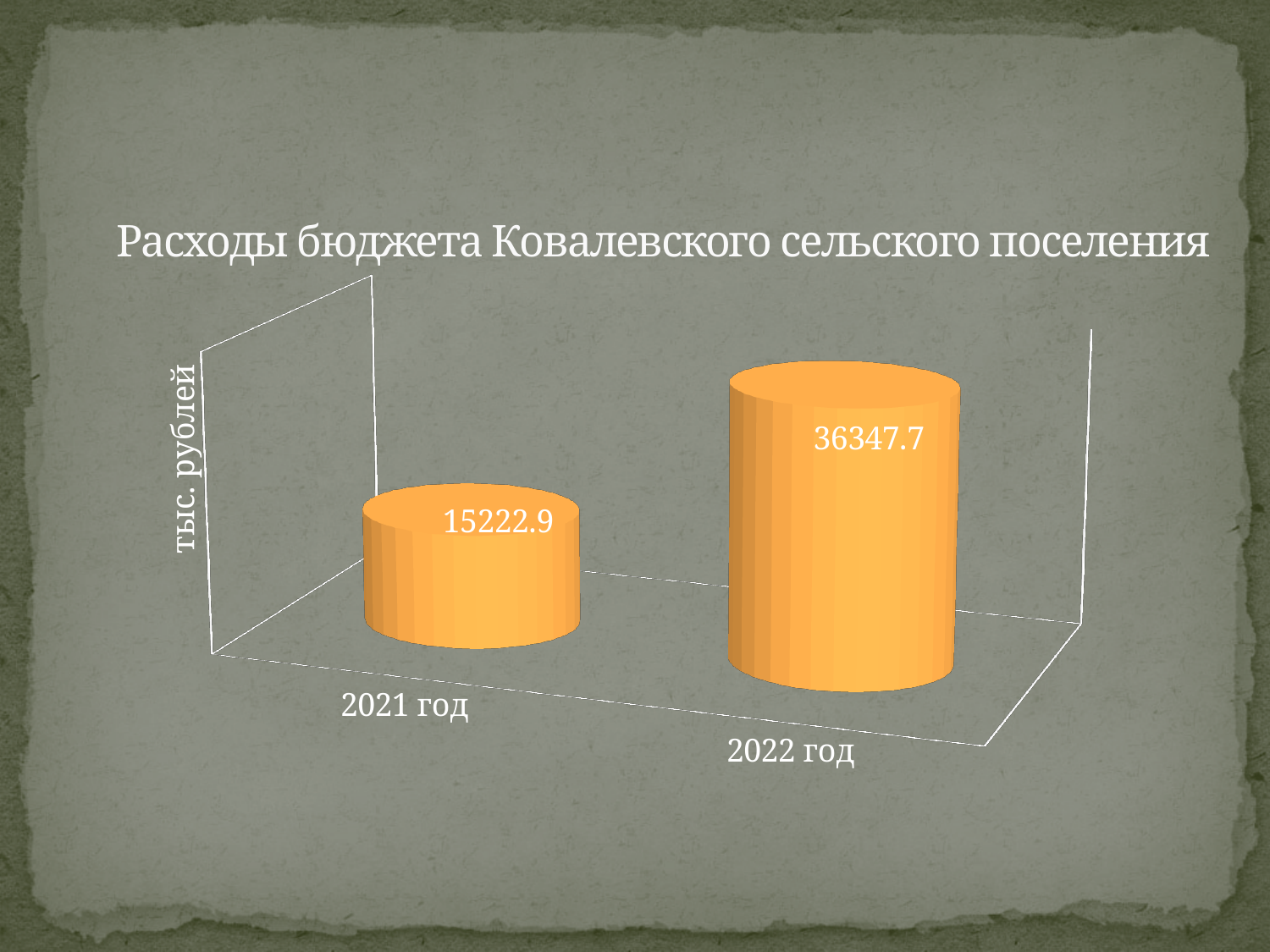
What kind of chart is shown on the slide? bar chart What is the title of the chart? Расходы бюджета Ковалевского сельского поселения What is the difference between the values for 2022 год and 2021 год? 21124.8 What is the value for 2021 год? 15222.9 Which is larger, the value for 2021 год or the value for 2022 год? 2022 год Which year has the highest value? 2022 год Do the values rise or fall from 2021 год to 2022 год? rise What is the value for 2022 год? 36347.7 How many categories are shown in the chart? 2 Which year has the lowest value? 2021 год What is the label on the vertical axis of the chart? тыс. рублей